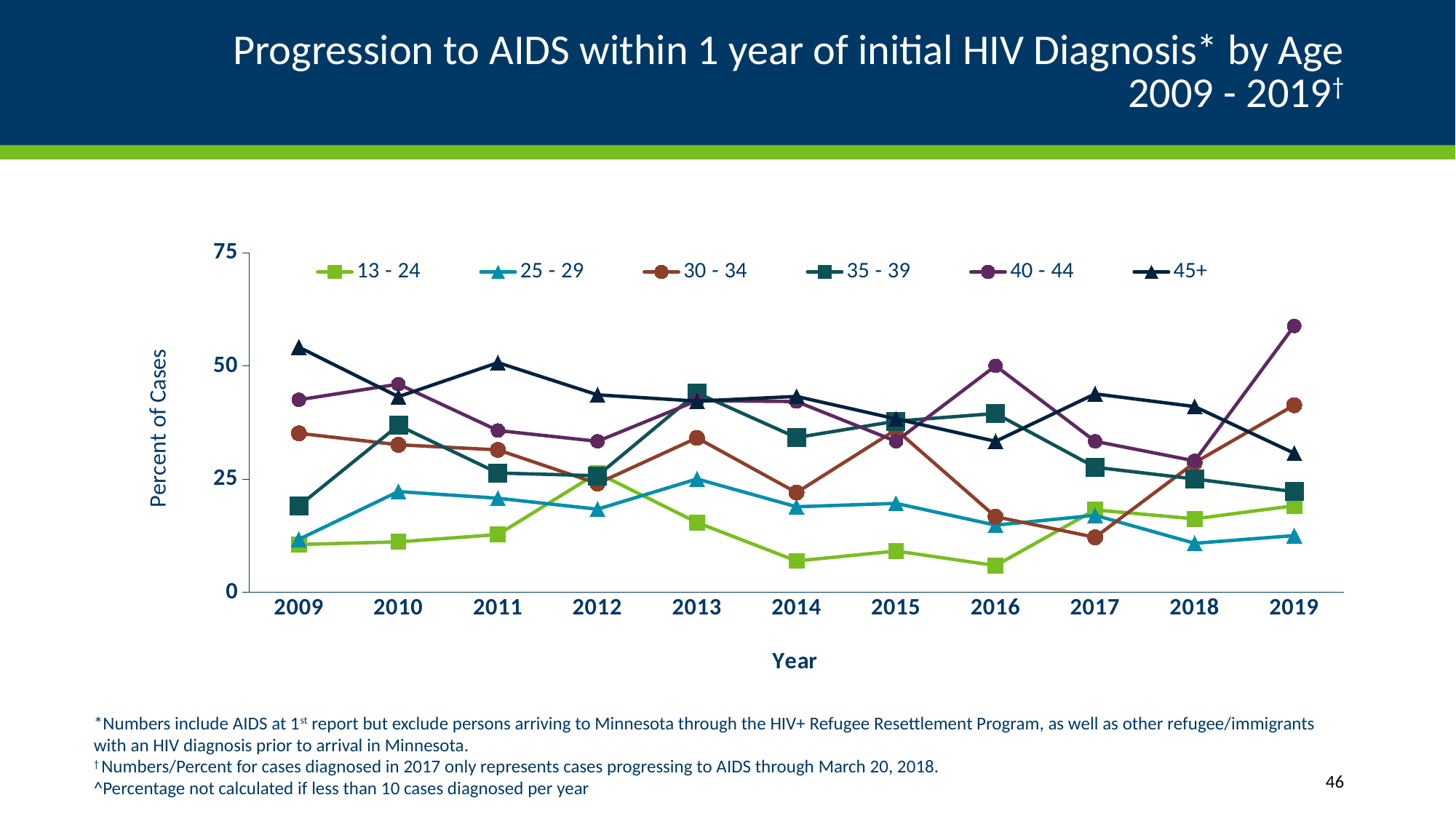
Is the value for the 40 - 44 group in 2019 greater or less than 50? greater How many years are plotted along the x axis? 11 How many series does the legend list? 6 Which age group has the lowest value in 2016? 13 - 24 Does the value for the 45+ group rise or fall from 2017 to 2019? fall Is the value for the 13 - 24 group in 2016 greater or less than 25? less Which age group has the highest value in 2019? 40 - 44 Which age group has the highest value in 2009? 45+ Is the value for the 45+ group in 2009 greater or less than 50? greater What kind of chart is shown on the slide? line chart What is the label on the y axis? Percent of Cases In 2019, which is larger: the value for 40 - 44 or the value for 25 - 29? 40 - 44